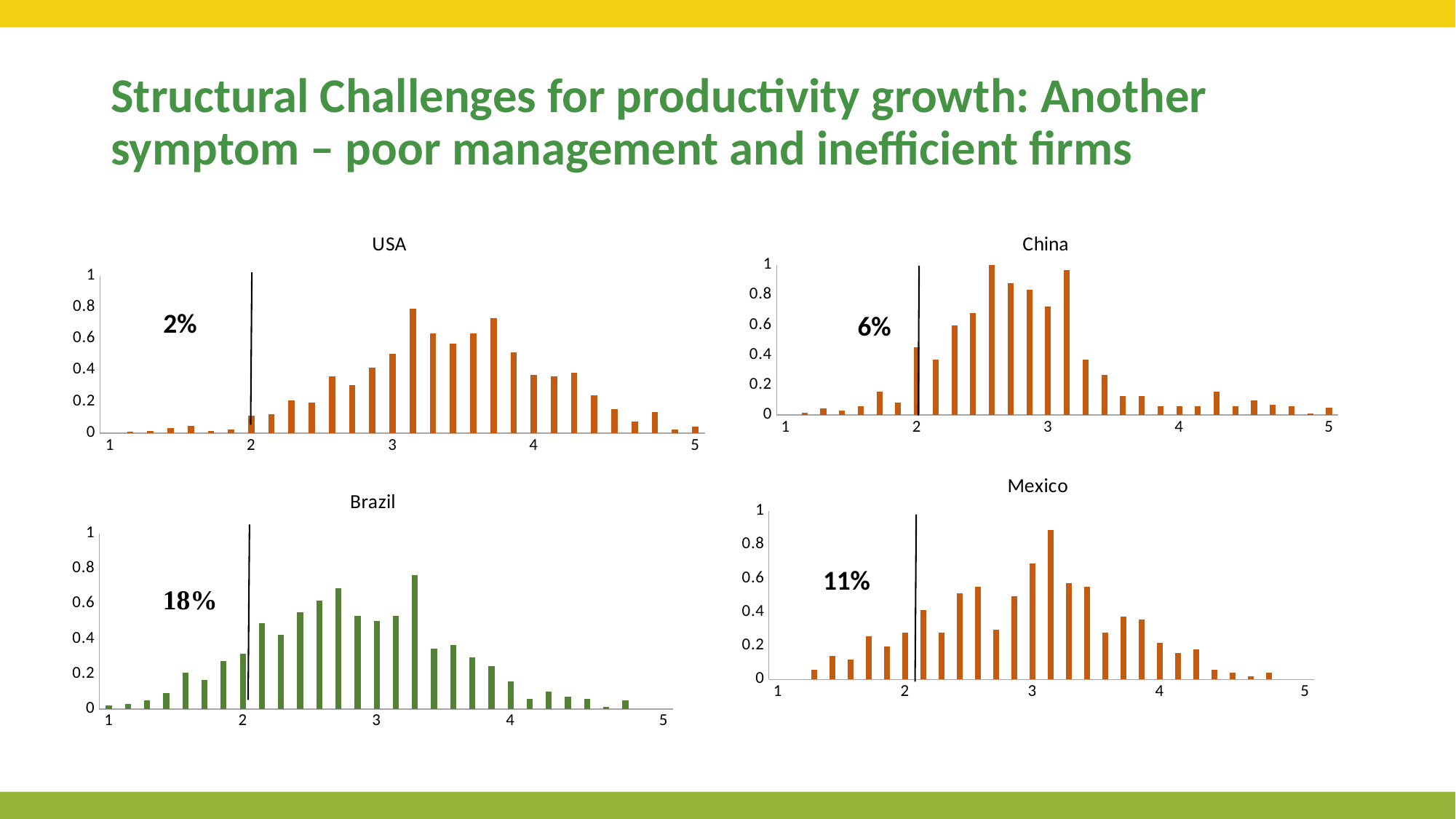
What percentage is printed on the Brazil chart? 18% Which chart on the slide uses green bars instead of orange? Brazil Which of the four country charts shows the highest printed percentage? Brazil Is the printed percentage on the Mexico chart larger or smaller than the one on the China chart? larger In the USA chart, is the tallest bar greater or less than 0.6? greater Which of the four country charts shows the lowest printed percentage? USA What percentage is printed on the China chart? 6% What kind of chart is the USA chart? bar chart How many charts are shown on the slide? 4 In the China chart, is the tallest bar greater or less than 0.8? greater What percentage is printed on the USA chart? 2% What percentage is printed on the Mexico chart? 11%